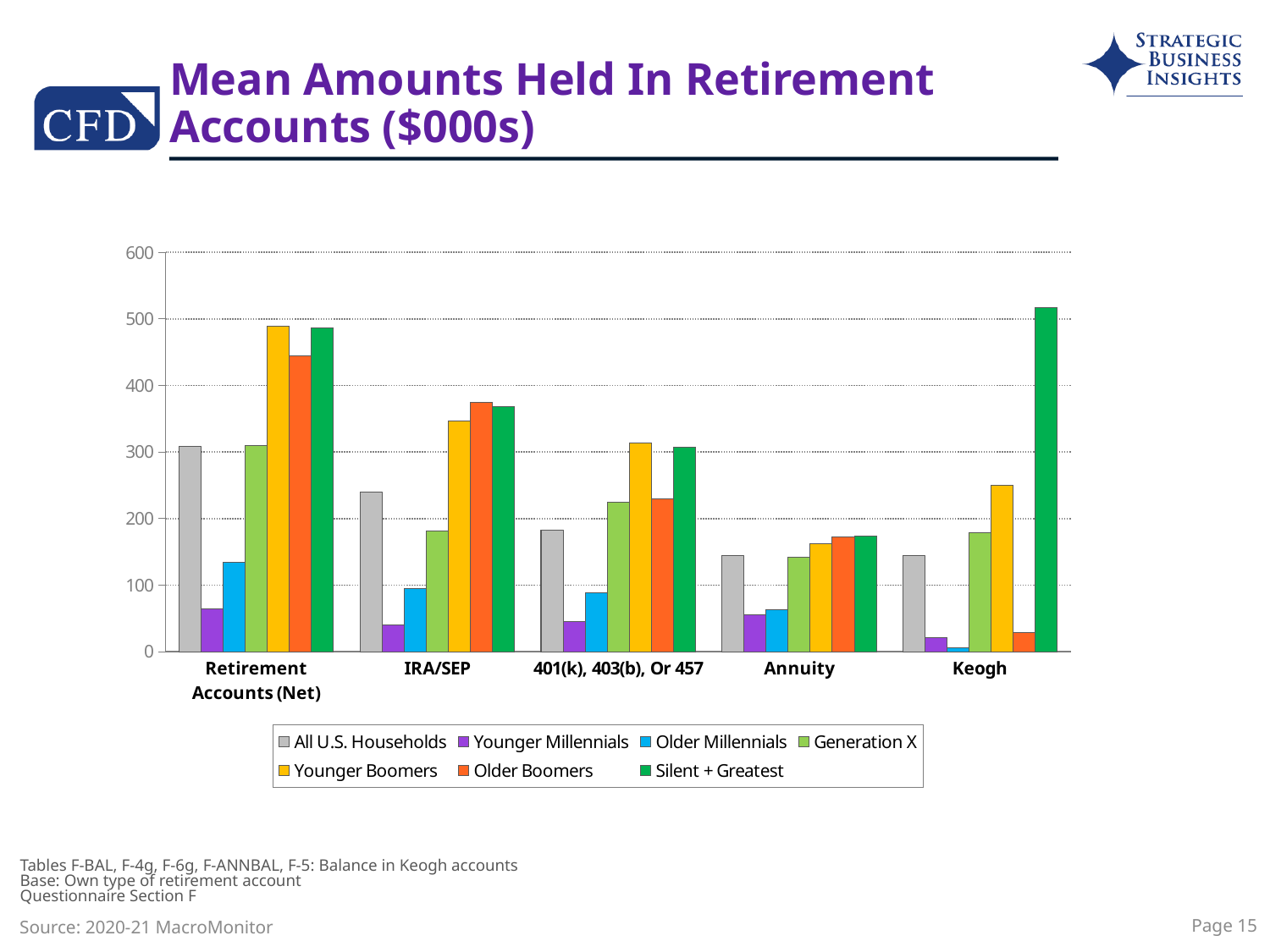
Which series has the highest value for Keogh? Silent + Greatest What kind of chart is shown on the slide? bar chart Is the value for All U.S. Households in Annuity greater or less than 100? greater How many series does the legend list? 7 Which series has the lowest value for Keogh? Older Millennials For 401(k), 403(b), Or 457, which is larger: Younger Boomers or Older Boomers? Younger Boomers How many account categories are shown along the x axis? 5 Is the value for Younger Boomers in Retirement Accounts (Net) greater or less than 400? greater For IRA/SEP, which is larger: Older Boomers or Generation X? Older Boomers What is the title of the chart? Mean Amounts Held In Retirement Accounts ($000s) Is the value for Younger Millennials in IRA/SEP greater or less than 100? less Which series has the lowest value for Retirement Accounts (Net)? Younger Millennials